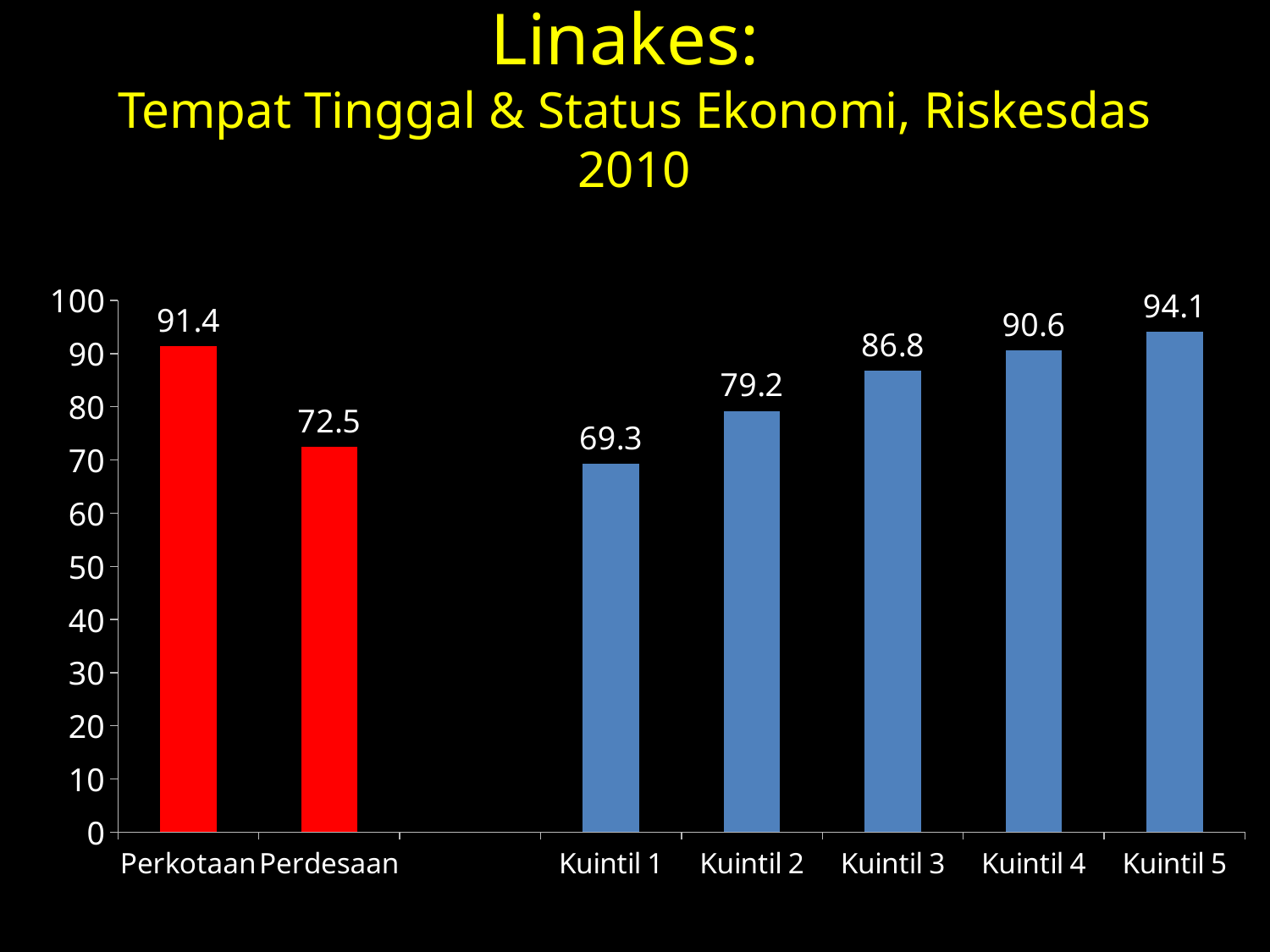
Which category has the lowest value? Kuintil 1 Which category has the highest value? Kuintil 5 What is the difference between the values for Kuintil 5 and Kuintil 1? 24.8 What is the value for Perkotaan? 91.4 What is the difference between the values for Perkotaan and Perdesaan? 18.9 What kind of chart is shown on the slide? bar chart Do the values rise or fall from Kuintil 1 to Kuintil 5? rise Is the value for Perdesaan greater or less than 80? less What is the value for Kuintil 1? 69.3 How many categories are shown on the x axis? 7 What is the value for Kuintil 3? 86.8 Which is larger, the value for Kuintil 2 or the value for Kuintil 4? Kuintil 4